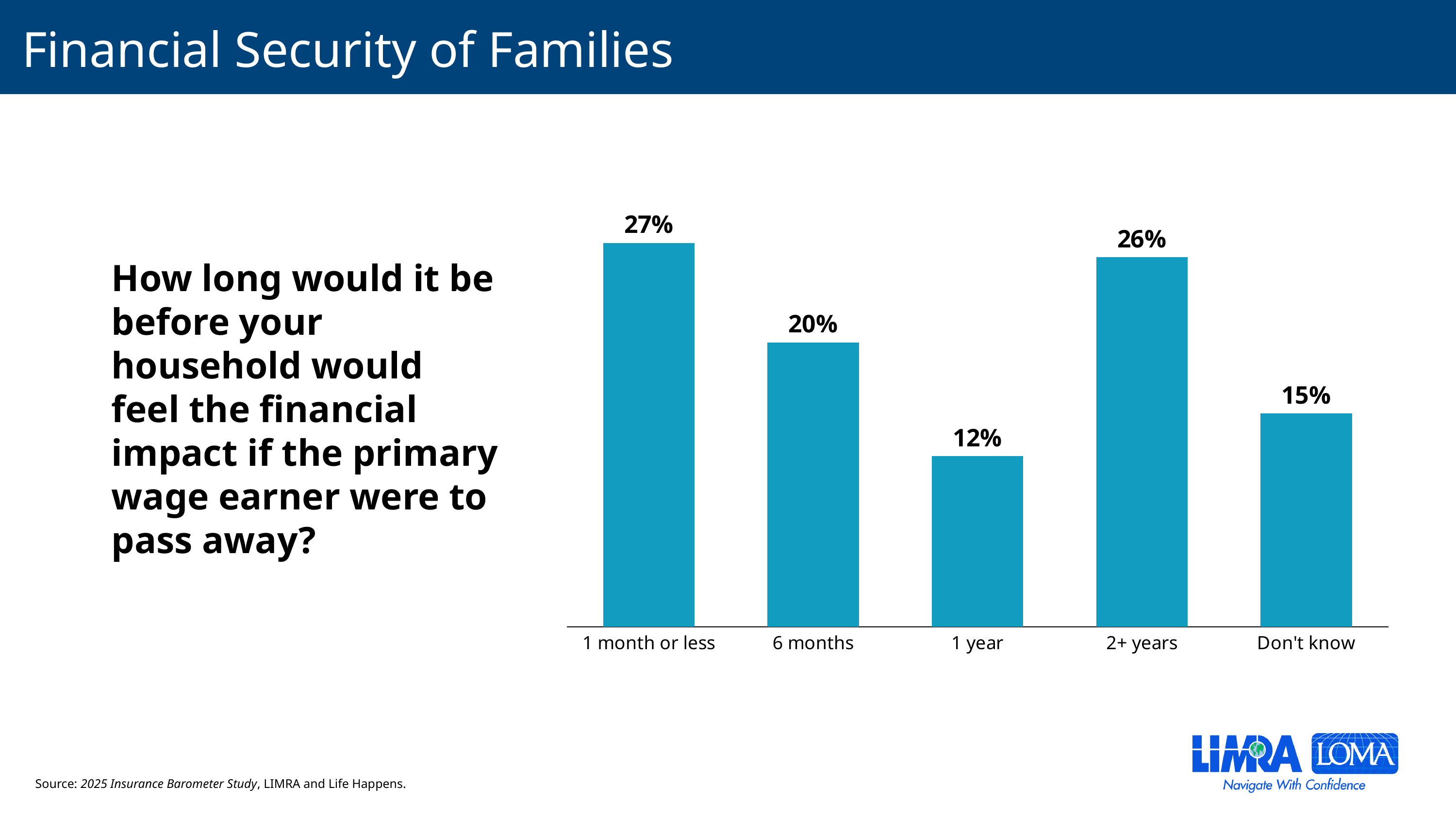
What is the difference between the values for 6 months and Don't know? 5% How many categories are shown on the chart? 5 What is the value for 2+ years? 26% Which category has the lowest value? 1 year Which is larger, the value for 6 months or the value for 2+ years? 2+ years What percentage of respondents said 1 month or less? 27% What is the difference between the values for 1 month or less and 1 year? 15% What is the value for 1 year? 12% What percentage of respondents answered Don't know? 15% What kind of chart is shown on the slide? Bar chart Which category has the highest value? 1 month or less What is the value for 6 months? 20%